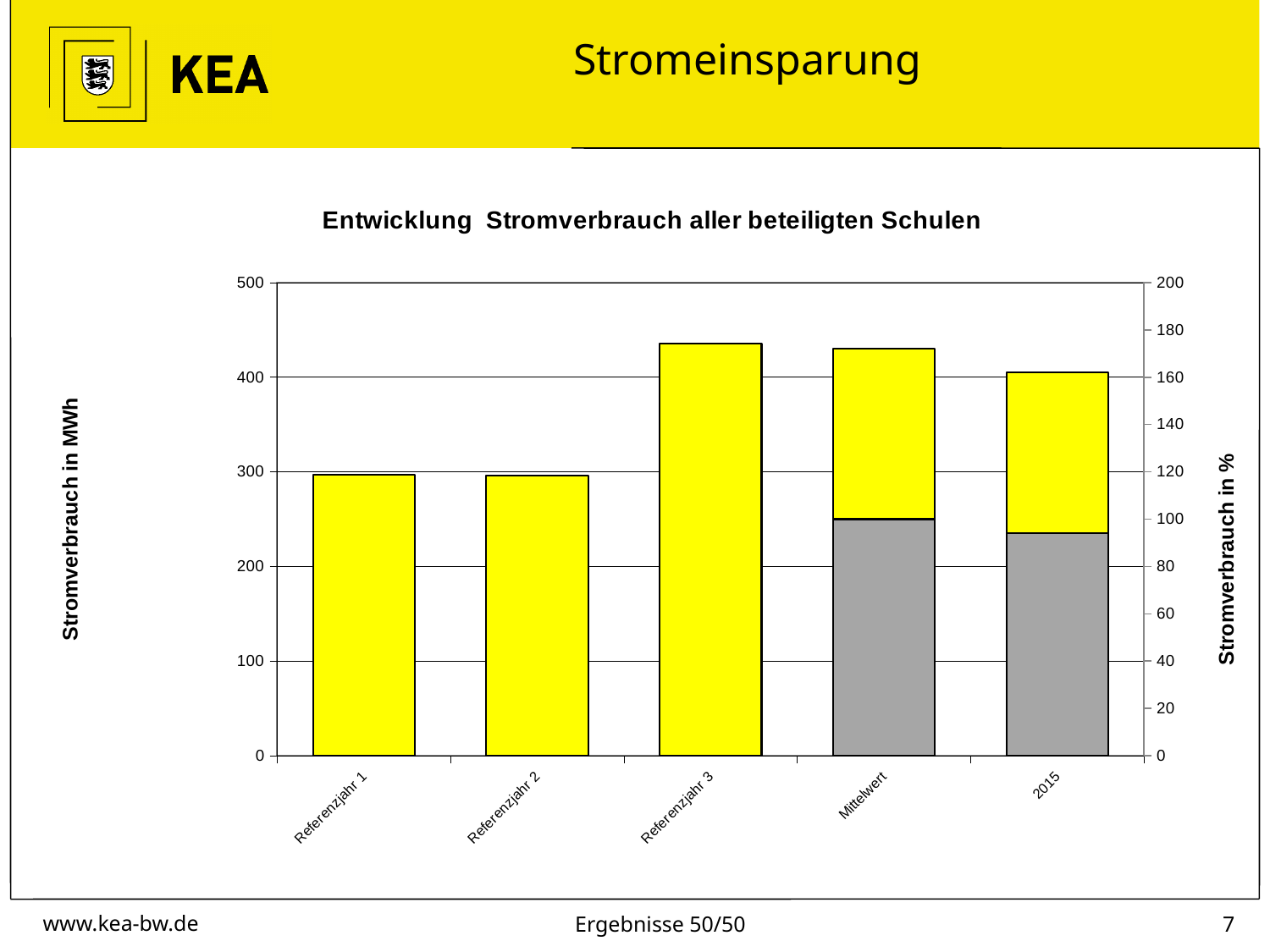
Which is larger, the value for Referenzjahr 3 or the value for Referenzjahr 1? Referenzjahr 3 Is the value for Referenzjahr 1 greater or less than 200 MWh? greater Which is larger, the yellow bar for Mittelwert or the yellow bar for 2015? Mittelwert Which is larger, the yellow bar for 2015 or the bar for Referenzjahr 2? 2015 What is the title of the chart? Entwicklung Stromverbrauch aller beteiligten Schulen How many categories are shown on the x axis of the chart? 5 Is the grey bar for 2015 on the right axis greater or less than 100%? less What is the label of the left vertical axis? Stromverbrauch in MWh What type of chart is shown on the slide? bar chart Is the value for Referenzjahr 3 greater or less than 400 MWh? greater